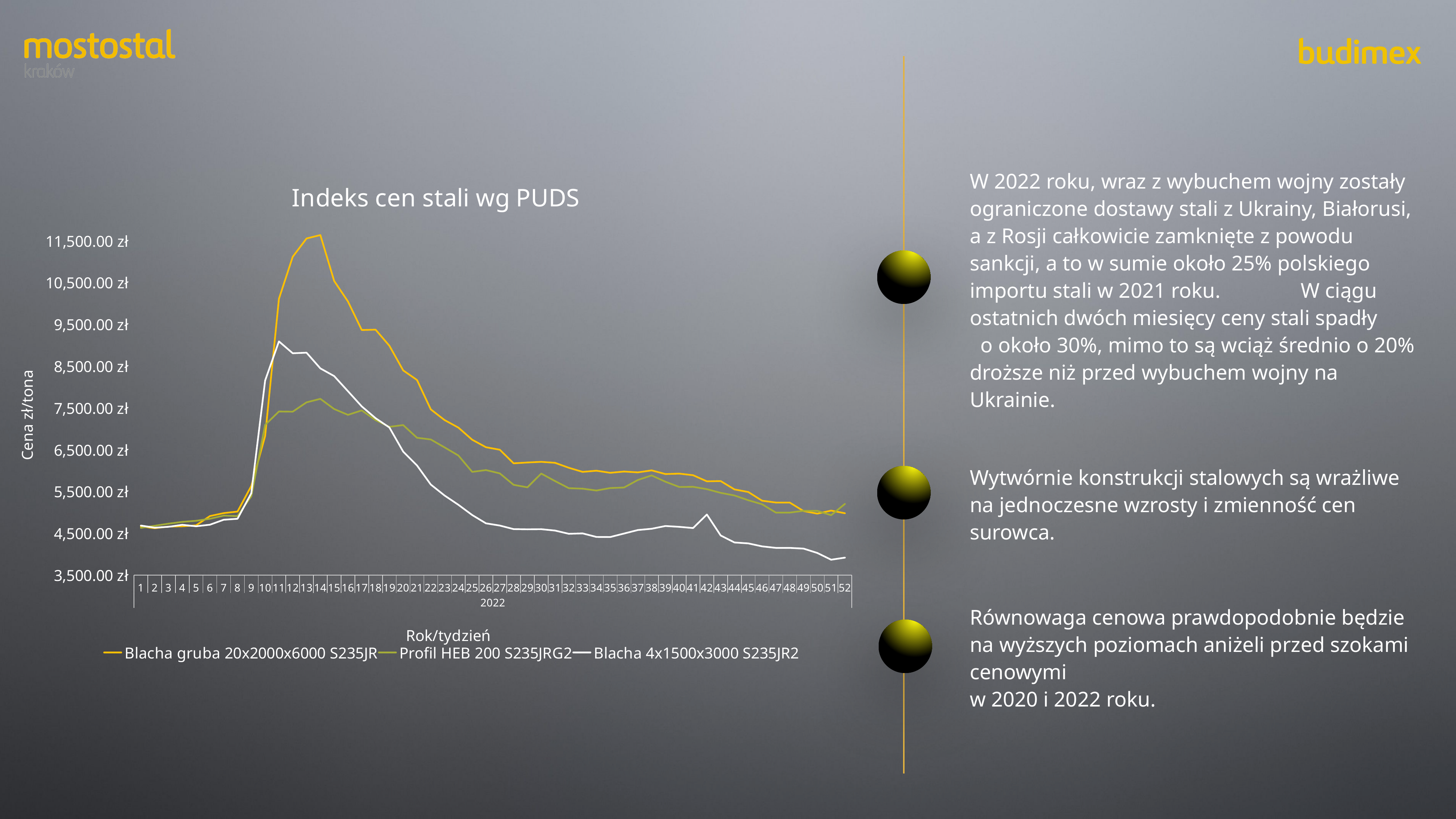
Is the value for Blacha 4x1500x3000 S235JR2 at week 52 greater or less than 4,500.00 zł? less How many series does the legend of the chart list? 3 What is the title of the chart? Indeks cen stali wg PUDS Which series has the lowest value at week 52? Blacha 4x1500x3000 S235JR2 Is the value for Profil HEB 200 S235JRG2 at week 11 greater or less than 6,500.00 zł? greater What is the label of the vertical axis of the chart? Cena zł/tona How many weekly data points are plotted along the x axis of the chart? 52 Does the value for Blacha gruba 20x2000x6000 S235JR rise or fall from week 14 to week 52? fall What kind of chart is shown on the slide? line chart At week 14, which series has the larger value: Blacha gruba 20x2000x6000 S235JR or Profil HEB 200 S235JRG2? Blacha gruba 20x2000x6000 S235JR Which series reaches the highest peak value in the chart? Blacha gruba 20x2000x6000 S235JR Is the value for Blacha gruba 20x2000x6000 S235JR at week 20 greater or less than 7,500.00 zł? greater